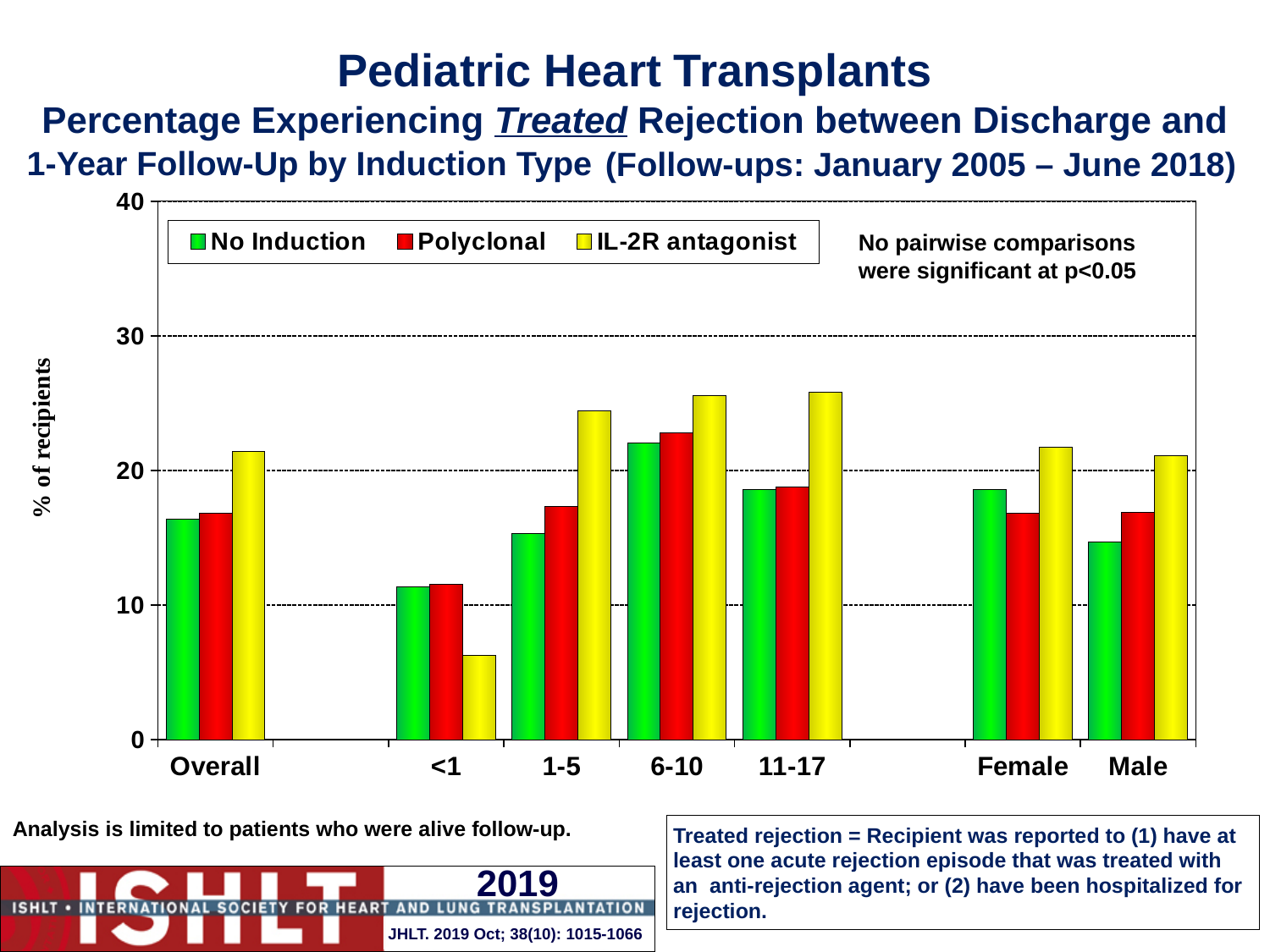
What is the label of the y axis? % of recipients How many series does the legend list? 3 Among the age groups, which has the lowest IL-2R antagonist value? <1 How many categories are shown along the x axis? 7 Is the IL-2R antagonist value for the 1-5 age group greater or less than 20? greater Is the No Induction value for the Male group greater or less than 20? less Which induction type has the lowest value for the <1 age group? IL-2R antagonist Does the IL-2R antagonist value rise or fall across the age groups from <1 to 11-17? rise Which induction type has the highest value for the 1-5 age group? IL-2R antagonist Is the IL-2R antagonist value for the <1 age group greater or less than 10? less What kind of chart is shown on the slide? bar chart Which is larger, the No Induction value for the 6-10 age group or for the <1 age group? 6-10